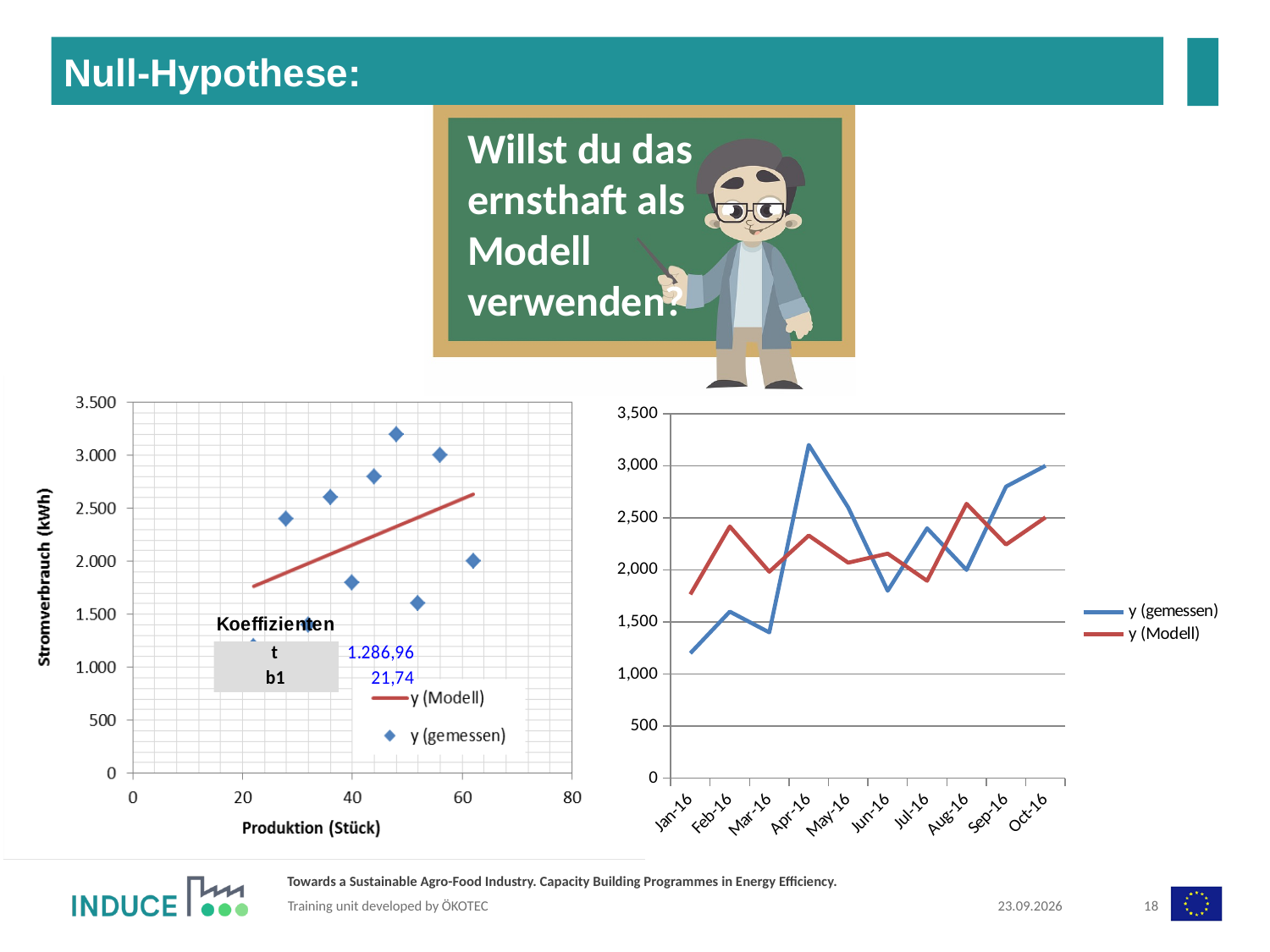
In the left-hand scatter chart, what is the title of the x axis? Produktion (Stück) In the right-hand line chart, is the value of y (gemessen) for Apr-16 greater or less than 3,000? greater In the right-hand line chart, in which month is y (gemessen) lowest? Jan-16 What kind of chart is the chart on the right side of the slide? line chart In the right-hand line chart, how many months are shown on the x axis? 10 In the right-hand line chart, how many series does the legend list? 2 In the right-hand line chart, which series has the larger value in Jan-16, y (gemessen) or y (Modell)? y (Modell) In the right-hand line chart, which series has the larger value in Apr-16, y (gemessen) or y (Modell)? y (gemessen) What kind of chart is the chart on the left side of the slide? scatter chart In the right-hand line chart, is the value of y (gemessen) for Jan-16 greater or less than 1,500? less In the right-hand line chart, in which month does y (gemessen) reach its highest value? Apr-16 In the left-hand scatter chart, what value is given for the coefficient b1 in the Koeffizienten box? 21,74